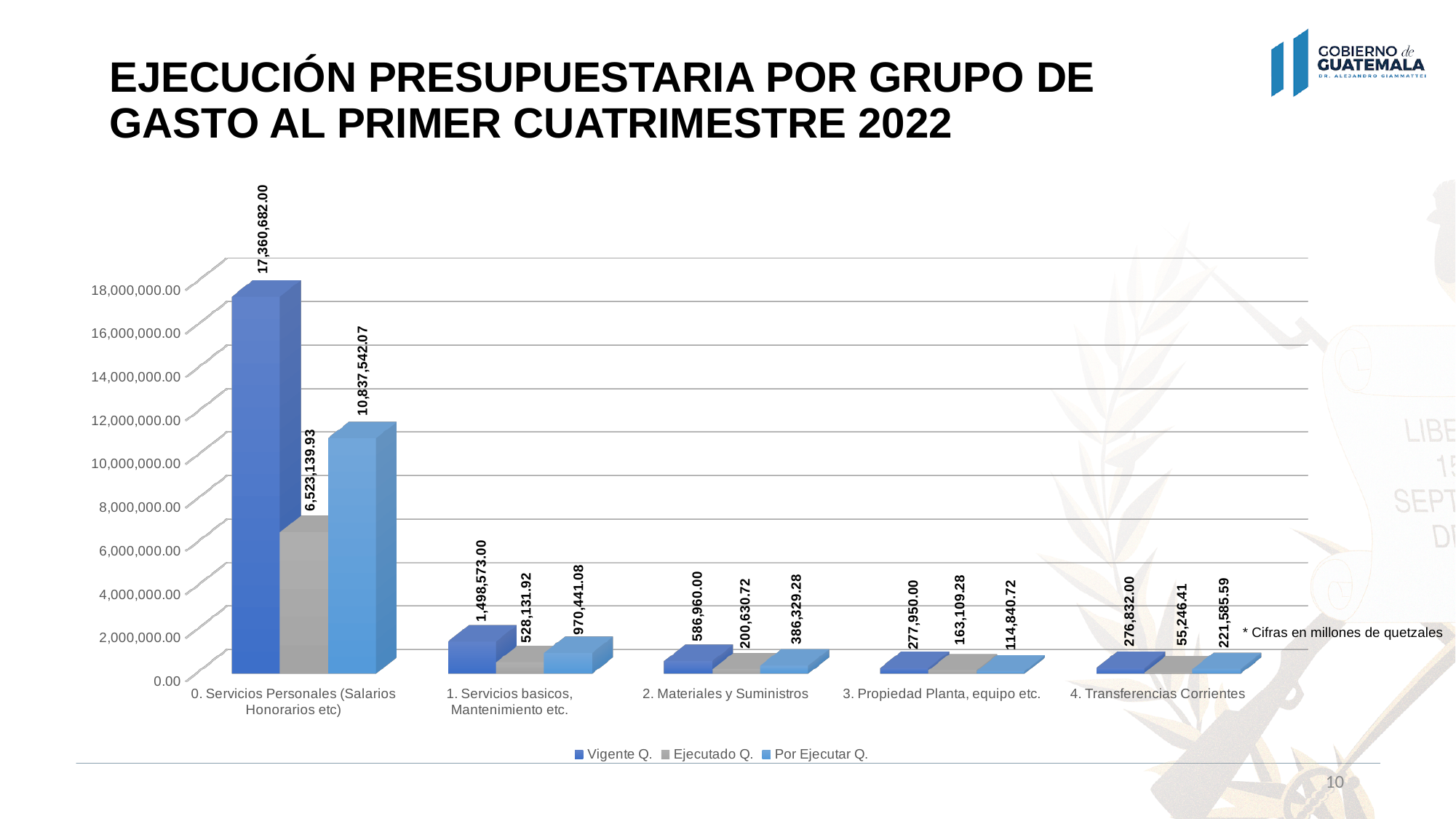
Is the Vigente Q. value for 0. Servicios Personales (Salarios Honorarios etc) greater or less than 16,000,000.00? greater How many expense group categories are shown on the x axis? 5 What is the Ejecutado Q. value for 1. Servicios basicos, Mantenimiento etc.? 528,131.92 What is the difference between the Vigente Q. and Ejecutado Q. values for 0. Servicios Personales (Salarios Honorarios etc)? 10,837,542.07 What kind of chart is shown on the slide? Bar chart What is the Vigente Q. value for 0. Servicios Personales (Salarios Honorarios etc)? 17,360,682.00 What is the Por Ejecutar Q. value for 2. Materiales y Suministros? 386,329.28 Which category has the highest Vigente Q. value? 0. Servicios Personales (Salarios Honorarios etc) What is the Ejecutado Q. value for 4. Transferencias Corrientes? 55,246.41 How many series does the legend list? 3 Which category has the lowest Ejecutado Q. value? 4. Transferencias Corrientes Which is larger for 3. Propiedad Planta, equipo etc.: the Ejecutado Q. value or the Por Ejecutar Q. value? Ejecutado Q.